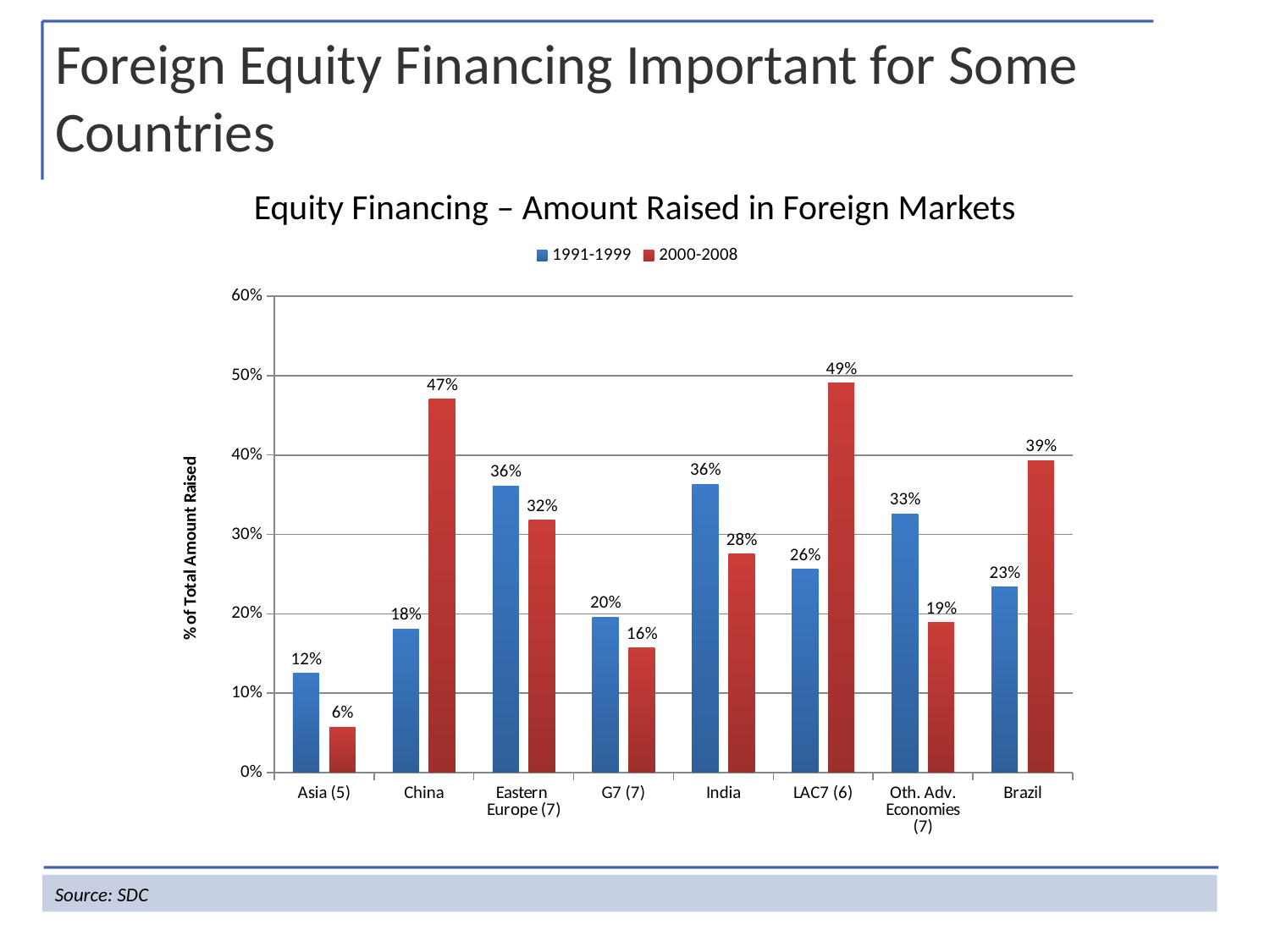
What is the value for China in the 2000-2008 series? 47% How many series does the legend list? 2 What is the value for Asia (5) in the 2000-2008 series? 6% What is the title of the chart? Equity Financing – Amount Raised in Foreign Markets How many categories are shown on the x axis? 8 Is the value for LAC7 (6) in the 2000-2008 series greater or less than 40%? greater Which is larger for G7 (7): the 1991-1999 value or the 2000-2008 value? 1991-1999 What is the difference between the 2000-2008 and 1991-1999 values for Brazil? 16% Which category has the lowest value in the 1991-1999 series? Asia (5) Which category has the highest value in the 2000-2008 series? LAC7 (6) What kind of chart is shown on the slide? Bar chart What is the value for India in the 1991-1999 series? 36%